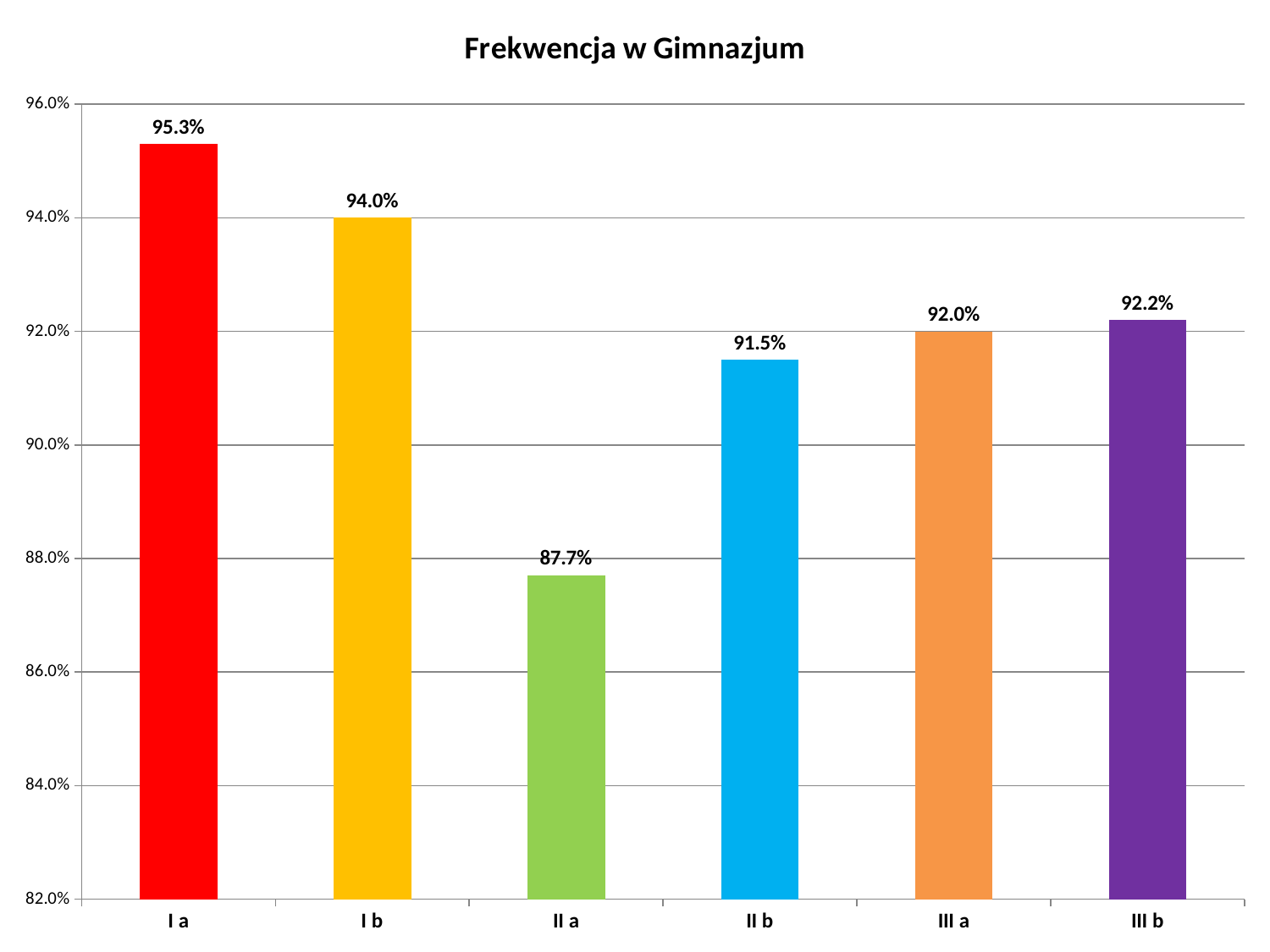
What is the attendance value for class I a? 95.3% What is the attendance value for class III b? 92.2% What is the difference between the attendance of III b and II a? 4.5% Is the value for II b greater or less than 92.0%? less What is the difference between the attendance of I a and I b? 1.3% Which has higher attendance, II b or III a? III a What is the attendance value for class II a? 87.7% What is the title of the chart? Frekwencja w Gimnazjum Which class has the highest attendance? I a Which class has the lowest attendance? II a How many classes are shown on the chart? 6 What kind of chart is this? bar chart